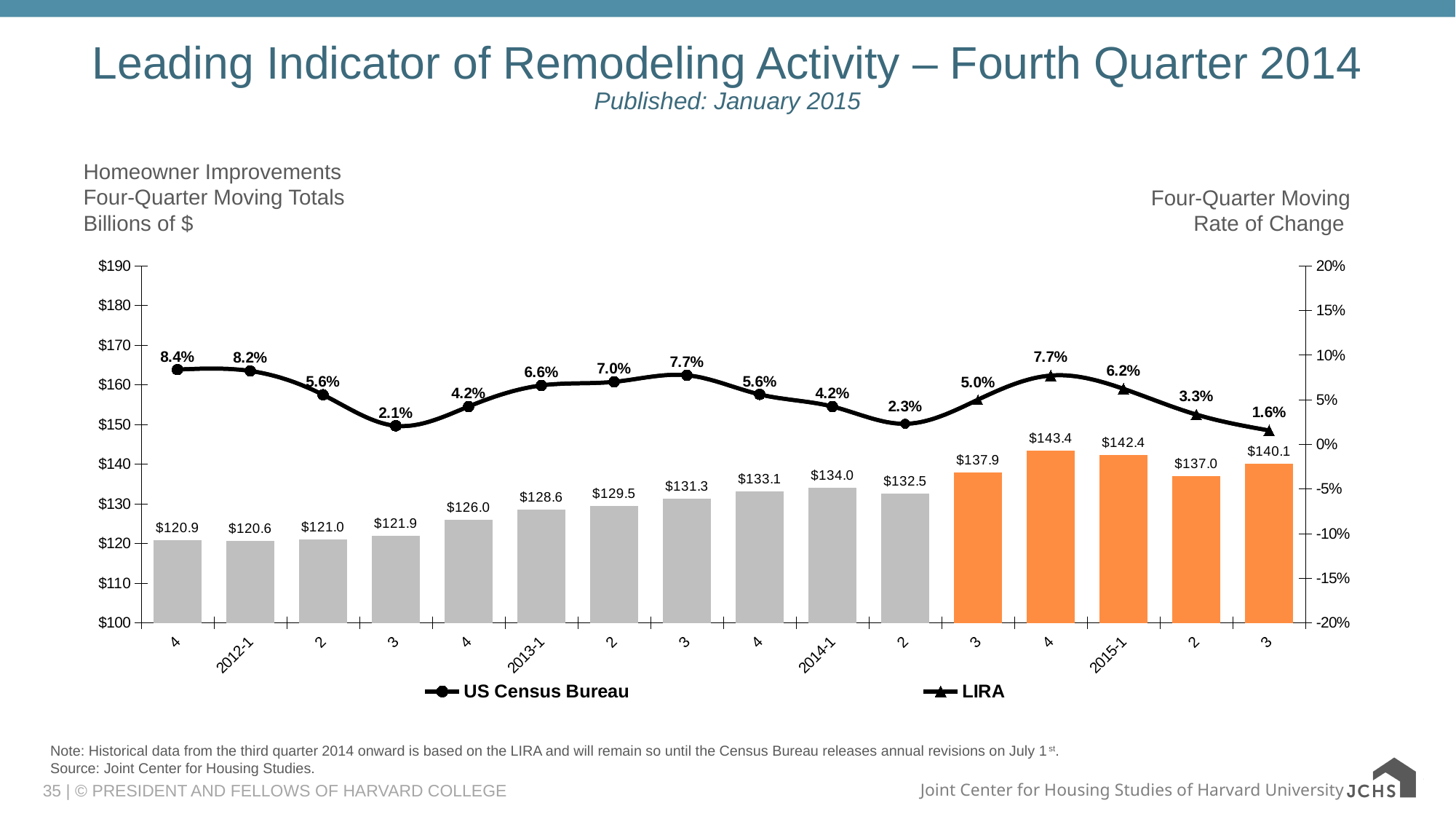
Which is larger, the four-quarter moving total for 2014 Q2 or 2014 Q3? 2014 Q3 ($137.9) What kind of chart is this? Combination bar and line chart What is the four-quarter moving total for 2013-1? $128.6 What is the four-quarter moving total for 2015-1? $142.4 Which quarter has the highest four-quarter moving total bar? 2014 Q4 ($143.4) What is the difference between the four-quarter moving totals for 2014-1 and 2013-1? $5.4 Which quarter has the lowest four-quarter moving total bar? 2012-1 ($120.6) How many series does the legend list? 2 What is the four-quarter moving rate of change for 2014-1? 4.2% How many quarterly bars are plotted on the chart? 16 How many bars are shaded orange? 5 What is the lowest four-quarter moving rate of change shown on the line? 1.6%